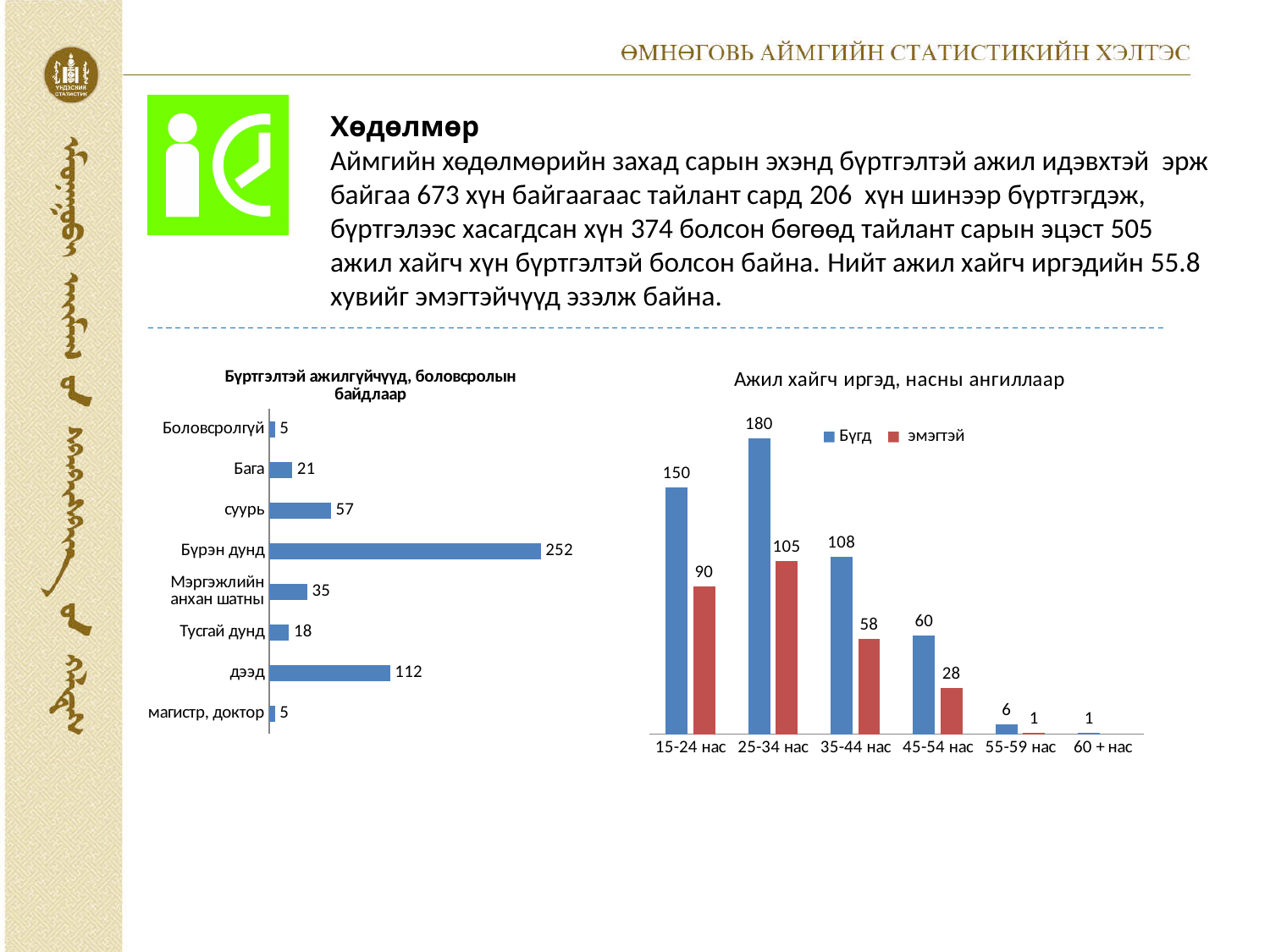
In the chart 'Бүртгэлтэй ажилгүйчүүд, боловсролын байдлаар', what is the value for Бүрэн дунд? 252 In the chart 'Ажил хайгч иргэд, насны ангиллаар', what is the эмэгтэй value for 35-44 нас? 58 In the chart 'Ажил хайгч иргэд, насны ангиллаар', which is larger: the Бүгд value for 35-44 нас or the эмэгтэй value for 25-34 нас? Бүгд for 35-44 нас In the chart 'Бүртгэлтэй ажилгүйчүүд, боловсролын байдлаар', what is the value for дээд? 112 In the chart 'Ажил хайгч иргэд, насны ангиллаар', which age group has the highest Бүгд value? 25-34 нас In the chart 'Бүртгэлтэй ажилгүйчүүд, боловсролын байдлаар', what is the difference between суурь and Бага? 36 In the chart 'Бүртгэлтэй ажилгүйчүүд, боловсролын байдлаар', which category has the highest value? Бүрэн дунд What type of chart is 'Бүртгэлтэй ажилгүйчүүд, боловсролын байдлаар'? Bar chart In the chart 'Ажил хайгч иргэд, насны ангиллаар', what is the Бүгд value for 25-34 нас? 180 In the chart 'Ажил хайгч иргэд, насны ангиллаар', how many series does the legend list? 2 In the chart 'Ажил хайгч иргэд, насны ангиллаар', what is the difference between Бүгд and эмэгтэй for 15-24 нас? 60 In the chart 'Бүртгэлтэй ажилгүйчүүд, боловсролын байдлаар', how many categories are shown? 8